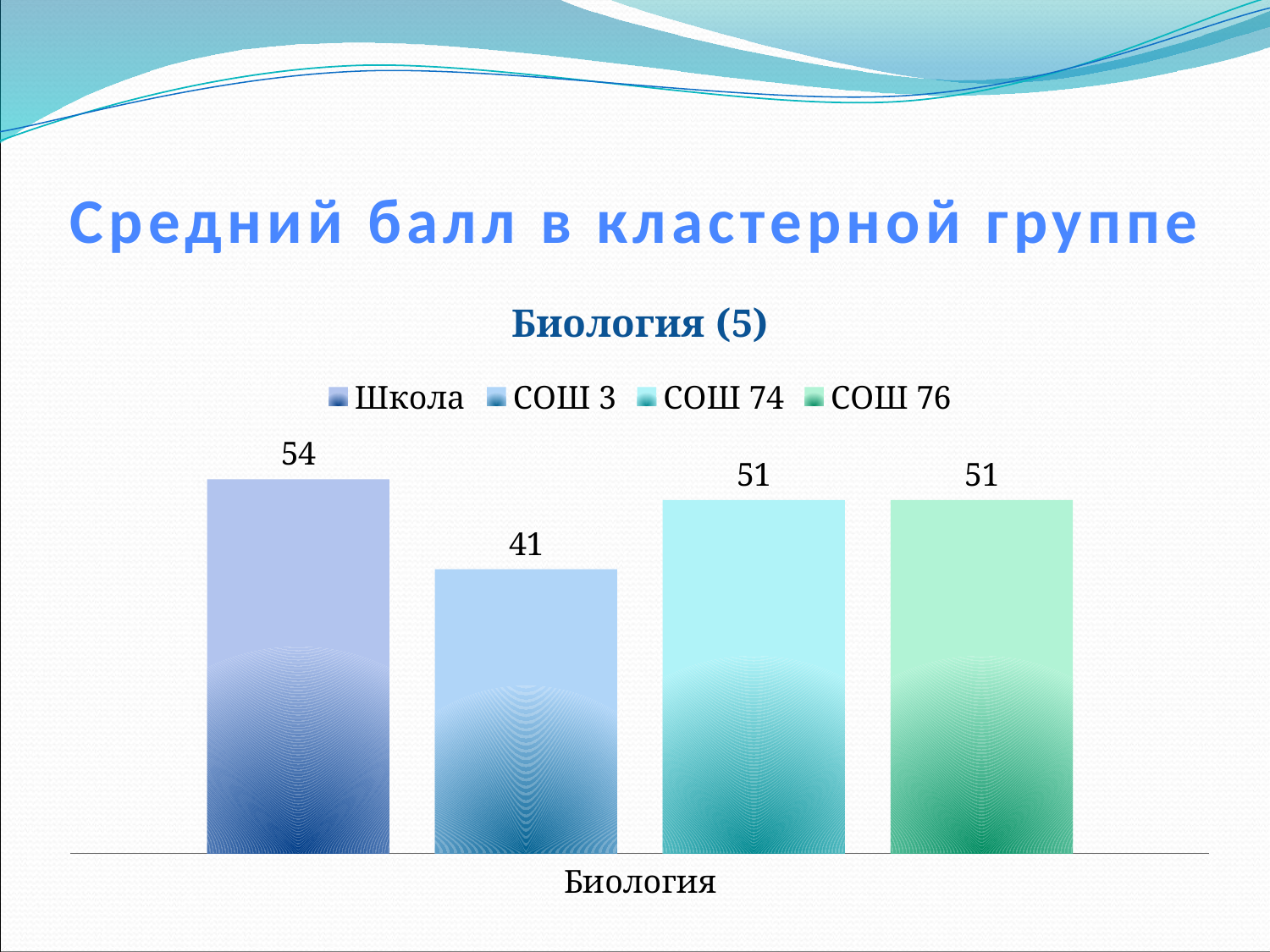
What is the title of the chart? Биология (5) Which series has the lowest value in the Биология (5) chart? СОШ 3 Which is larger, the value for Школа or the value for СОШ 76? Школа Which series has the highest value in the Биология (5) chart? Школа What is the value for СОШ 3 in the Биология (5) chart? 41 What is the value for СОШ 76 in the Биология (5) chart? 51 What is the difference between the values for Школа and СОШ 3? 13 How many series does the legend list? 4 What is the value for СОШ 74 in the Биология (5) chart? 51 What kind of chart is shown on the slide? Bar chart What is the difference between the values for Школа and СОШ 74? 3 What is the value for Школа in the Биология (5) chart? 54